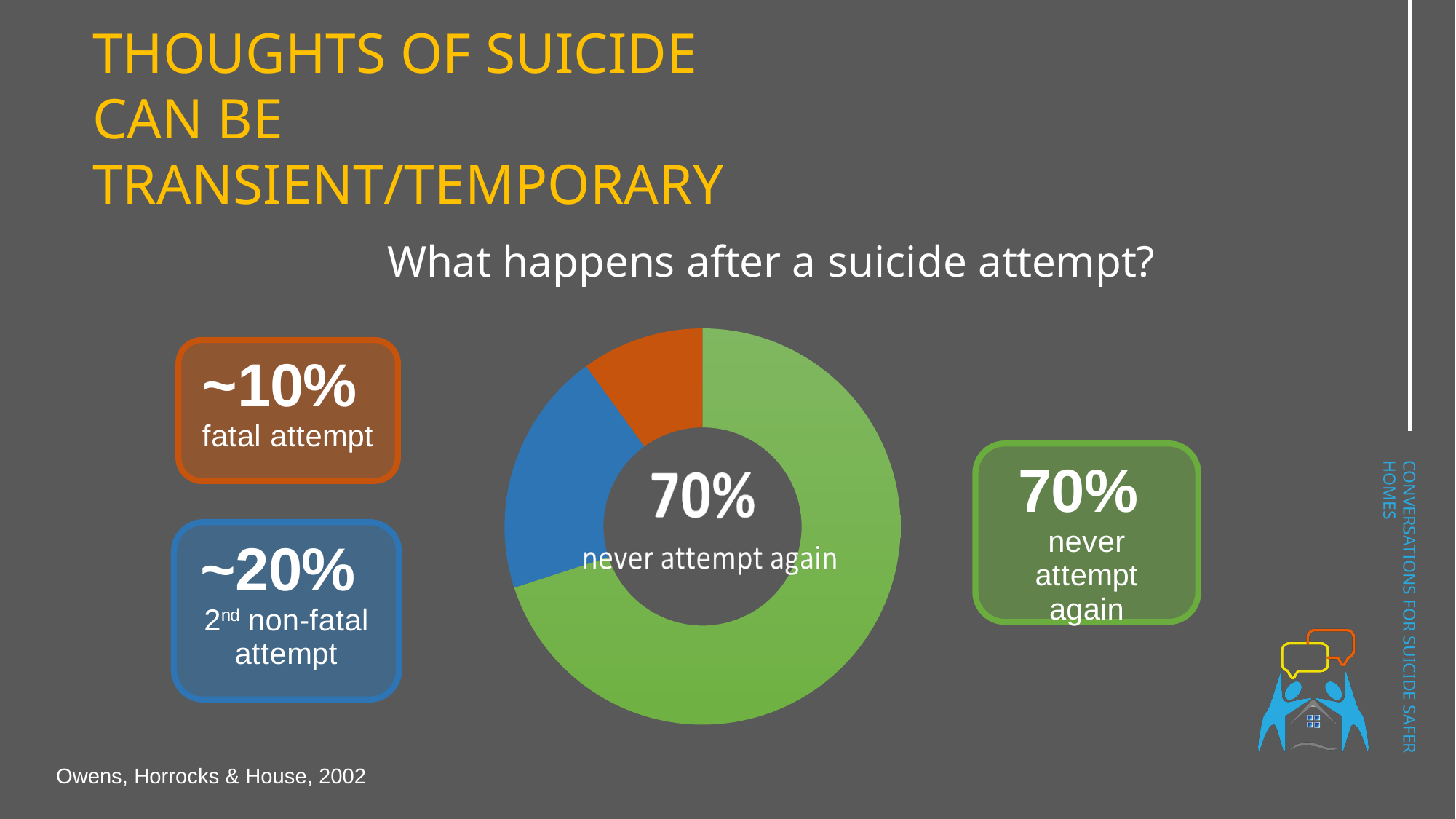
What colour is the slice representing a fatal attempt? orange What value is shown for a fatal attempt? ~10% What value is shown for a 2nd non-fatal attempt? ~20% Which is larger: the share for 2nd non-fatal attempt or the share for fatal attempt? 2nd non-fatal attempt How many slices does the chart have? 3 Which outcome has the largest slice of the chart? never attempt again What share of the chart does the green slice represent? 70% What colour is the slice representing 'never attempt again'? green Which outcome has the smallest slice of the chart? fatal attempt What kind of chart is shown on the slide? pie chart (donut) What text is printed in the centre of the donut chart? 70% never attempt again What percentage of people never attempt again, according to the chart? 70%